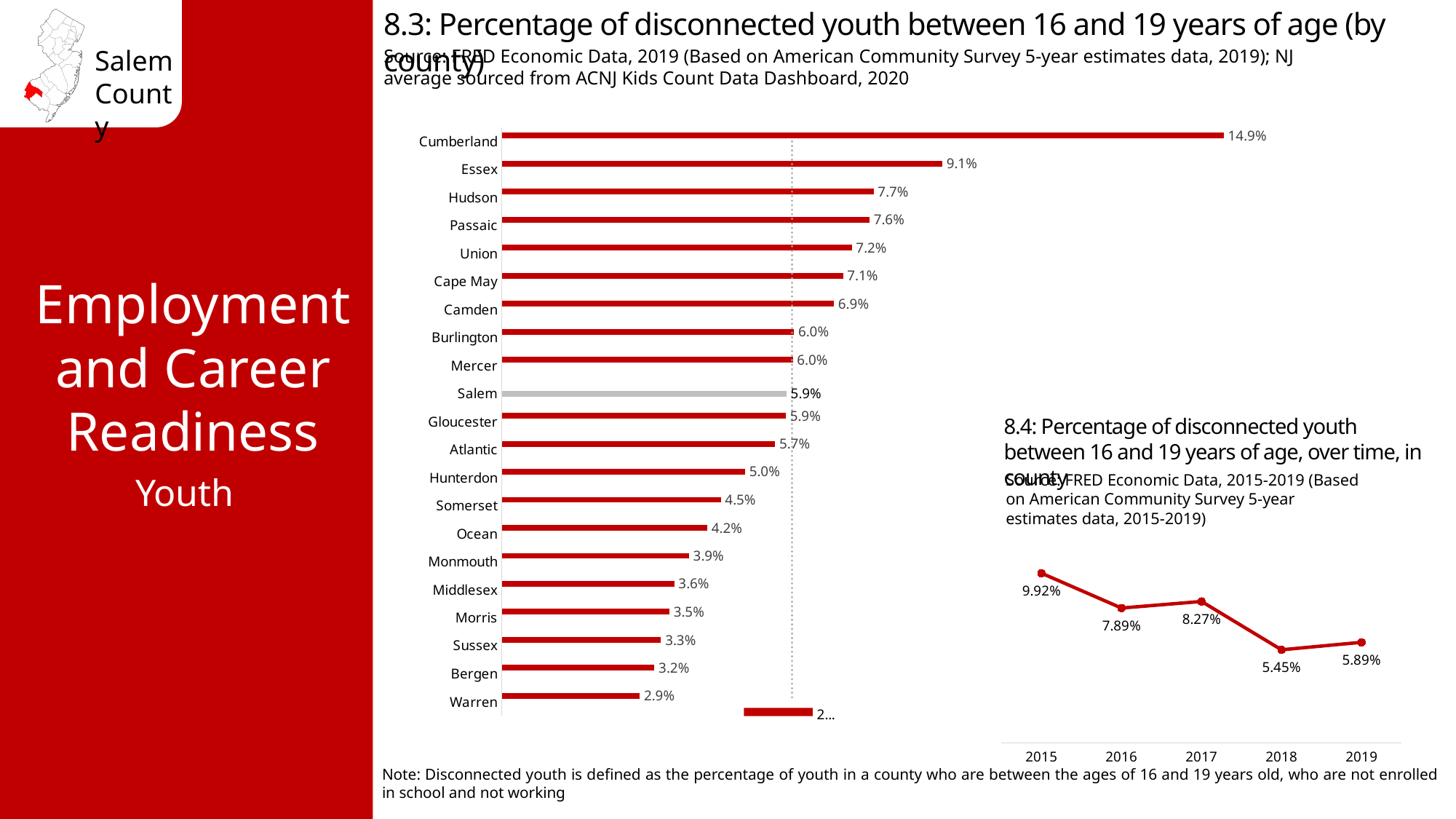
What type of chart is chart 8.3 (by county)? Bar chart In the chart 8.4 (over time), what is the difference between the values for 2019 and 2018? 0.44% In the chart 8.3 (by county), which has a higher value, Camden or Hunterdon? Camden What type of chart is chart 8.4 (over time)? Line chart In the chart 8.4 (over time), what is the percentage of disconnected youth in 2015? 9.92% In the chart 8.4 (over time), which year has the lowest percentage of disconnected youth? 2018 In the chart 8.3 (by county), which county has the highest percentage of disconnected youth? Cumberland In the chart 8.3 (by county), what is the percentage of disconnected youth for Cumberland? 14.9% In the chart 8.3 (by county), which county has the lowest percentage of disconnected youth? Warren In the chart 8.3 (by county), what is the difference between the values for Essex and Hudson? 1.4% In the chart 8.3 (by county), how many counties are shown? 21 In the chart 8.3 (by county), what is the percentage of disconnected youth for Salem? 5.9%